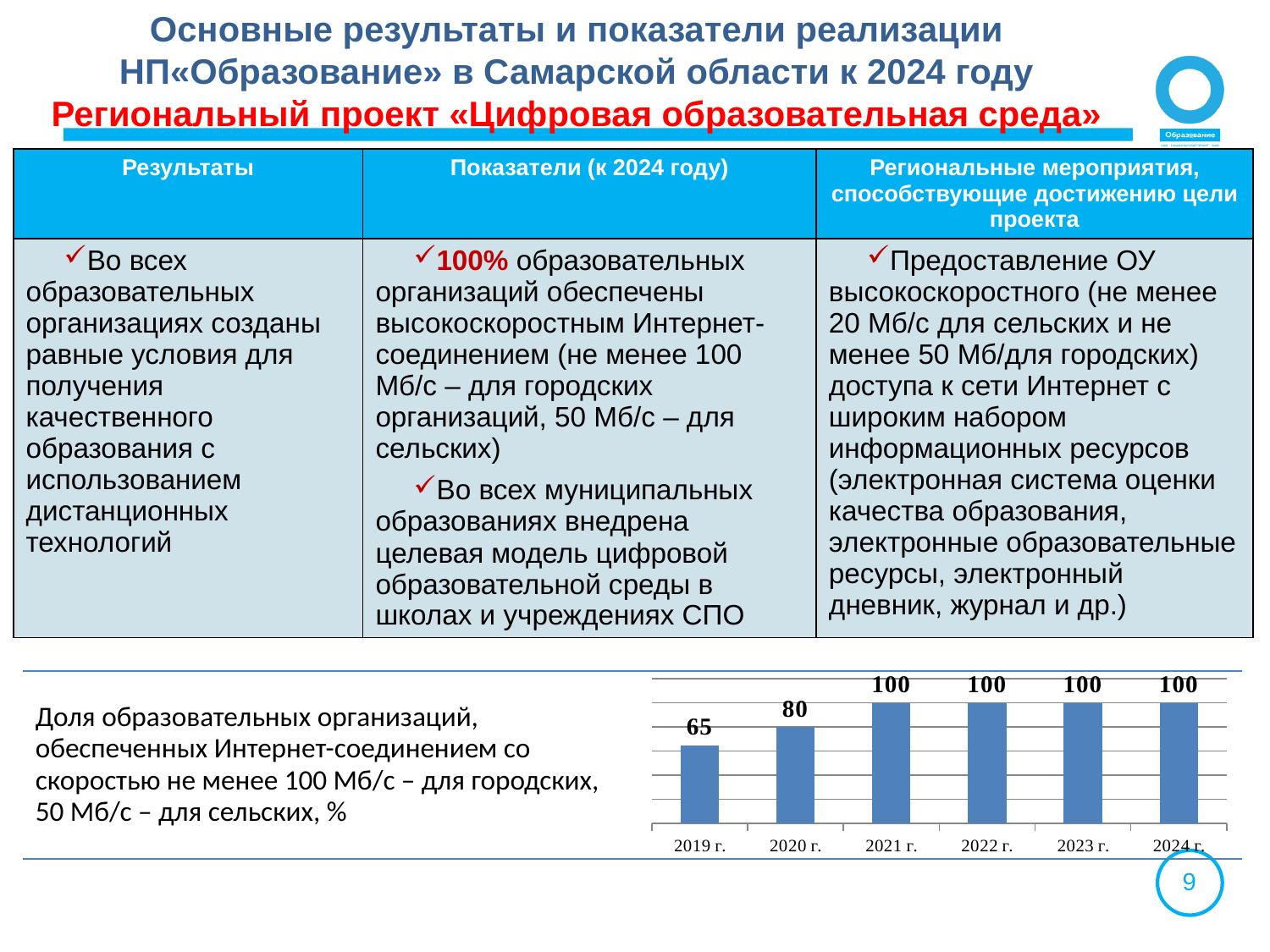
Do the values in the bar chart rise or fall from 2019 г. to 2021 г.? rise Which is larger, the value for 2019 г. or the value for 2020 г.? 2020 г. What is the value for 2019 г. in the bar chart? 65 What kind of chart is shown at the bottom of the slide? bar chart What is the value for 2024 г. in the bar chart? 100 What is the value for 2020 г. in the bar chart? 80 How many years in the bar chart have a value of 100? 4 What is the difference between the values for 2020 г. and 2019 г.? 15 Which year has the lowest value in the bar chart? 2019 г. What is the value for 2021 г. in the bar chart? 100 What is the difference between the values for 2021 г. and 2019 г.? 35 How many years are shown on the x axis of the bar chart? 6